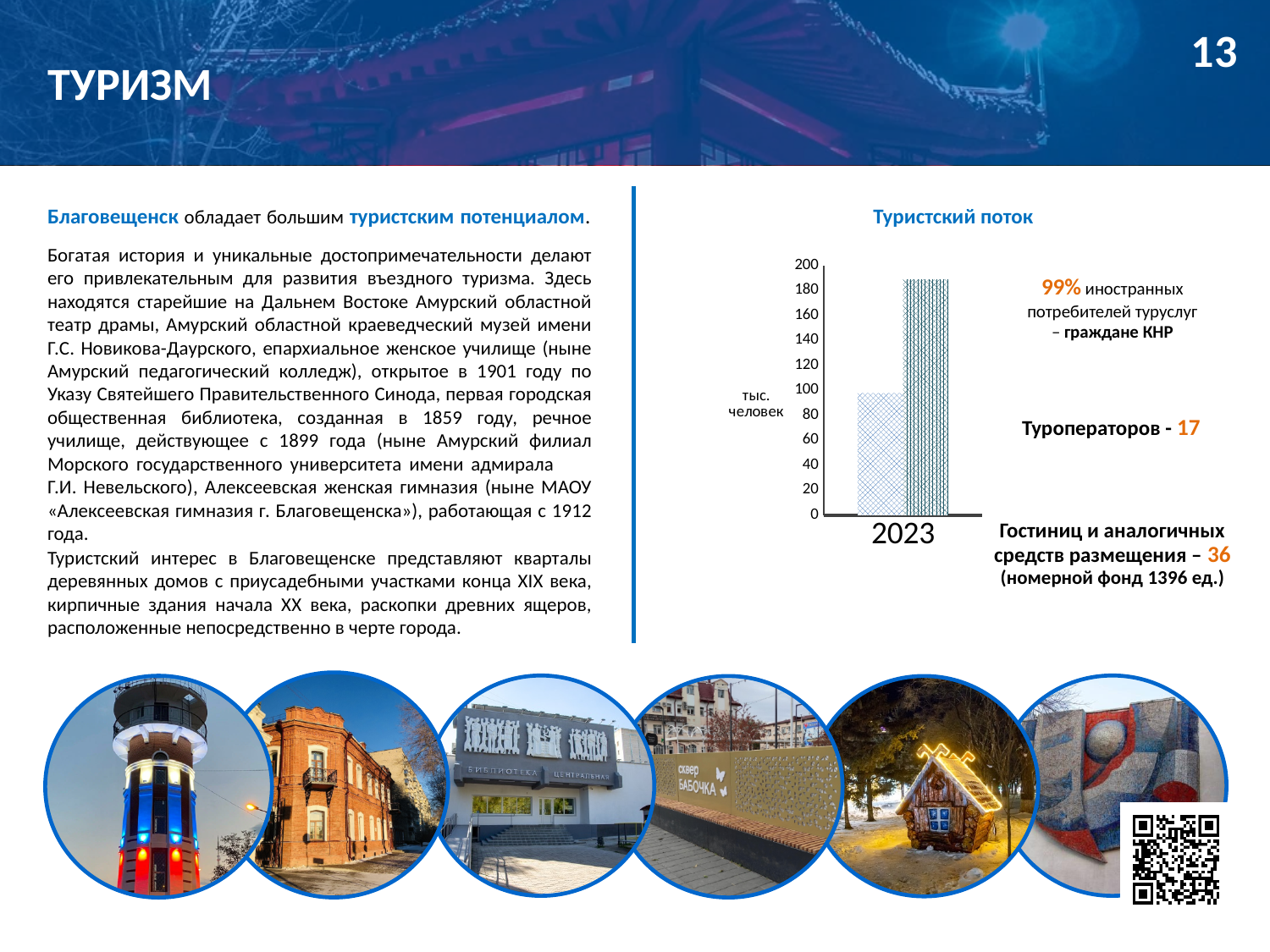
In the "Туристский поток" chart, which bar is taller, the left one or the right one? the right one What kind of chart is shown under the title "Туристский поток"? bar chart Which year is labelled on the x axis of the "Туристский поток" chart? 2023 How many bars are plotted in the "Туристский поток" chart? 2 What unit label is written next to the vertical axis of the "Туристский поток" chart? тыс. человек What is the title of the chart on the right side of the slide? Туристский поток In the "Туристский поток" chart, is the value of the left bar greater or less than 80? greater In the "Туристский поток" chart, is the value of the right bar greater or less than 180? greater What is the highest tick value shown on the vertical axis of the "Туристский поток" chart? 200 How many categories are shown on the x axis of the "Туристский поток" chart? 1 In the "Туристский поток" chart, is the value of the right bar greater or less than 200? less